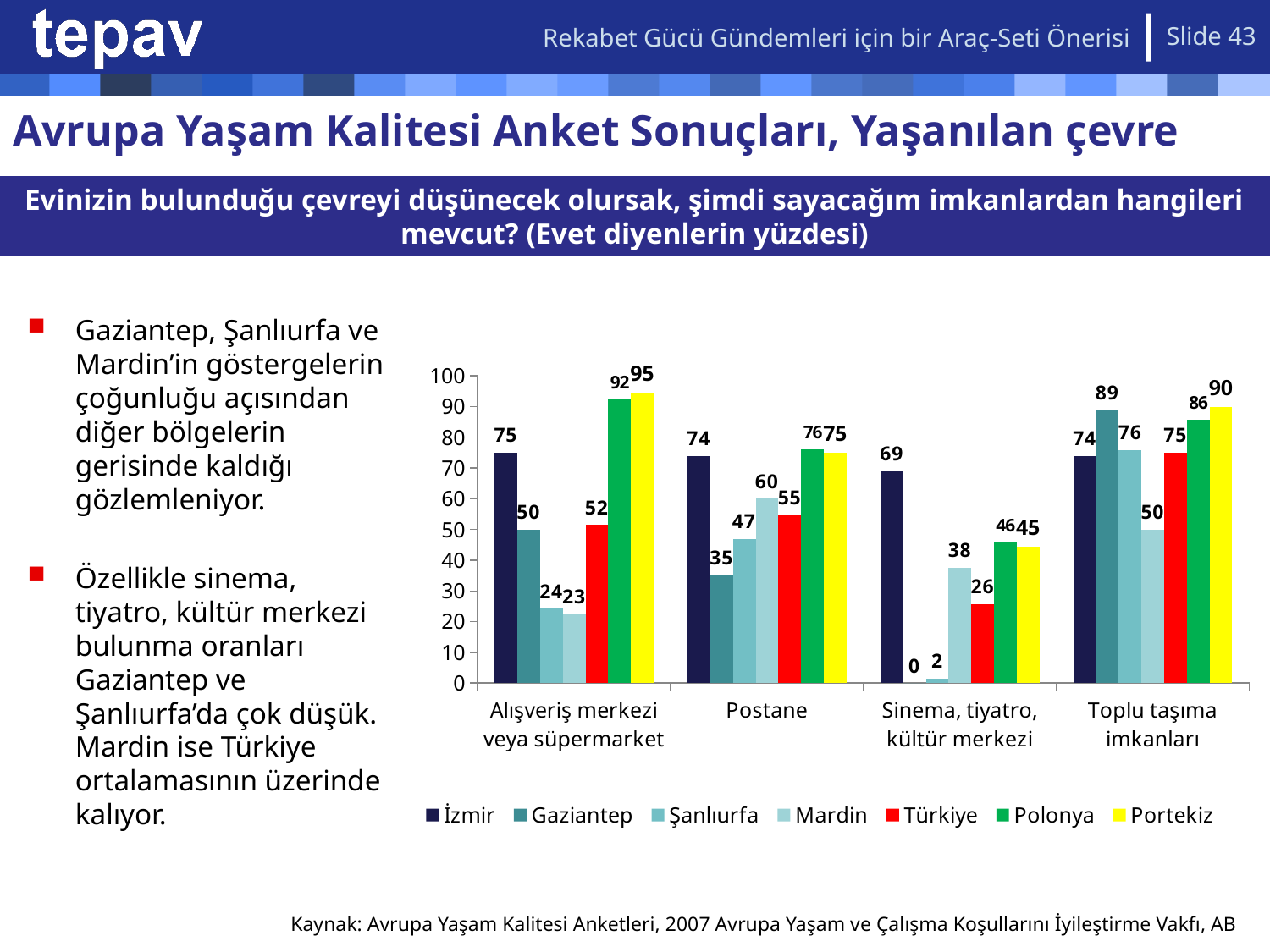
Which series has the lowest value in the Alışveriş merkezi veya süpermarket category? Mardin What is the value for Polonya in the Alışveriş merkezi veya süpermarket category? 92 In the Postane category, which is larger: the value for Şanlıurfa or the value for Gaziantep? Şanlıurfa How many series does the legend list? 7 What is the difference between the Portekiz and Şanlıurfa values in the Alışveriş merkezi veya süpermarket category? 71 What kind of chart is shown on the slide? Bar chart How many categories are shown on the x axis? 4 Which series is shown in red in the legend? Türkiye What is the difference between the Gaziantep and Mardin values in the Toplu taşıma imkanları category? 39 What is the value for Mardin in the Postane category? 60 What is the value for Gaziantep in the Sinema, tiyatro, kültür merkezi category? 0 Which series has the highest value in the Toplu taşıma imkanları category? Portekiz